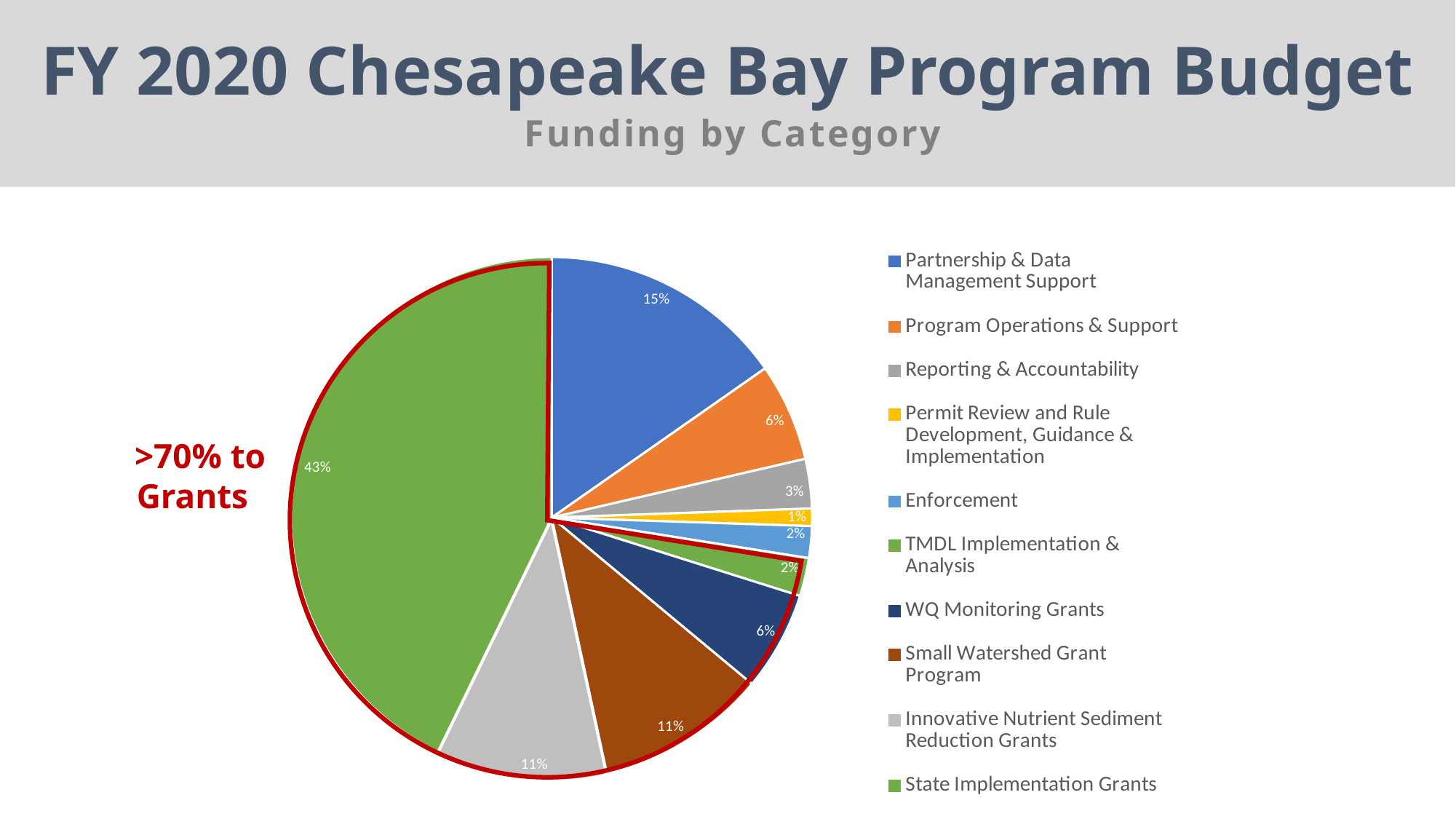
What share of the budget goes to Partnership & Data Management Support? 15% What share of the budget goes to Reporting & Accountability? 3% What share of the budget goes to the Small Watershed Grant Program? 11% What does the red annotation next to the pie chart say? >70% to Grants What is the title of the slide? FY 2020 Chesapeake Bay Program Budget What is the difference in percentage points between State Implementation Grants and Partnership & Data Management Support? 28 How many categories does the legend list? 10 Which category has the smallest share of the budget? Permit Review and Rule Development, Guidance & Implementation Which is larger, the share for Program Operations & Support or the share for Reporting & Accountability? Program Operations & Support What share of the budget goes to State Implementation Grants? 43% What kind of chart is shown on the slide? pie chart Which category has the largest share of the budget? State Implementation Grants